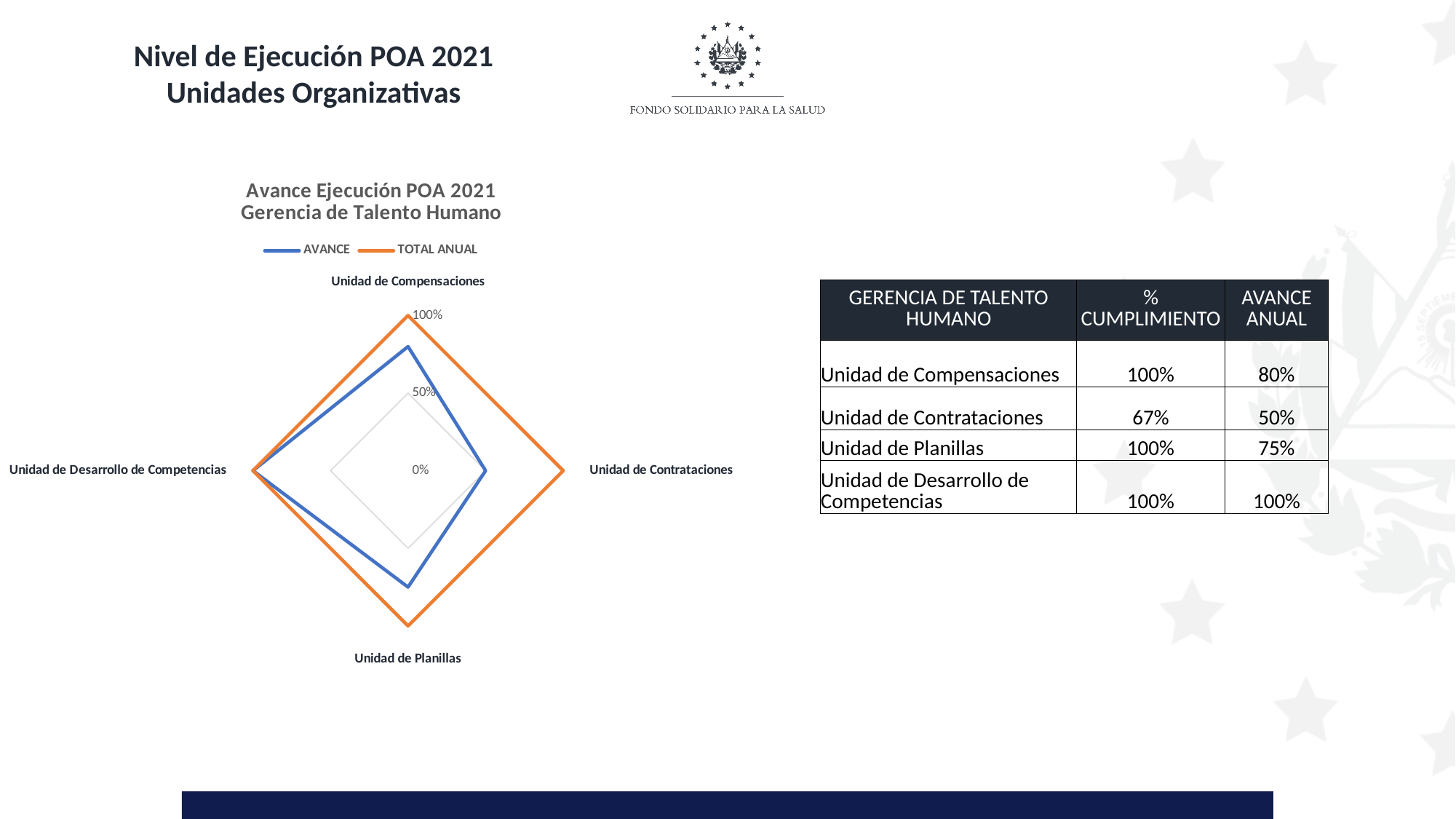
Which category has the lowest AVANCE value in the radar chart? Unidad de Contrataciones What is the AVANCE value for Unidad de Desarrollo de Competencias in the radar chart? 100% How many categories (axes) does the radar chart have? 4 How many series does the legend of the radar chart list? 2 Which has the larger AVANCE value: Unidad de Compensaciones or Unidad de Contrataciones? Unidad de Compensaciones What is the TOTAL ANUAL value for Unidad de Contrataciones in the radar chart? 100% What is the title of the radar chart? Avance Ejecución POA 2021 Gerencia de Talento Humano Is the AVANCE value for Unidad de Planillas greater or less than 100%? less What are the two series named in the radar chart's legend? AVANCE and TOTAL ANUAL What kind of chart is shown on the slide? Radar chart What is the AVANCE value for Unidad de Contrataciones in the radar chart? 50% Is the AVANCE value for Unidad de Compensaciones greater or less than 50%? greater